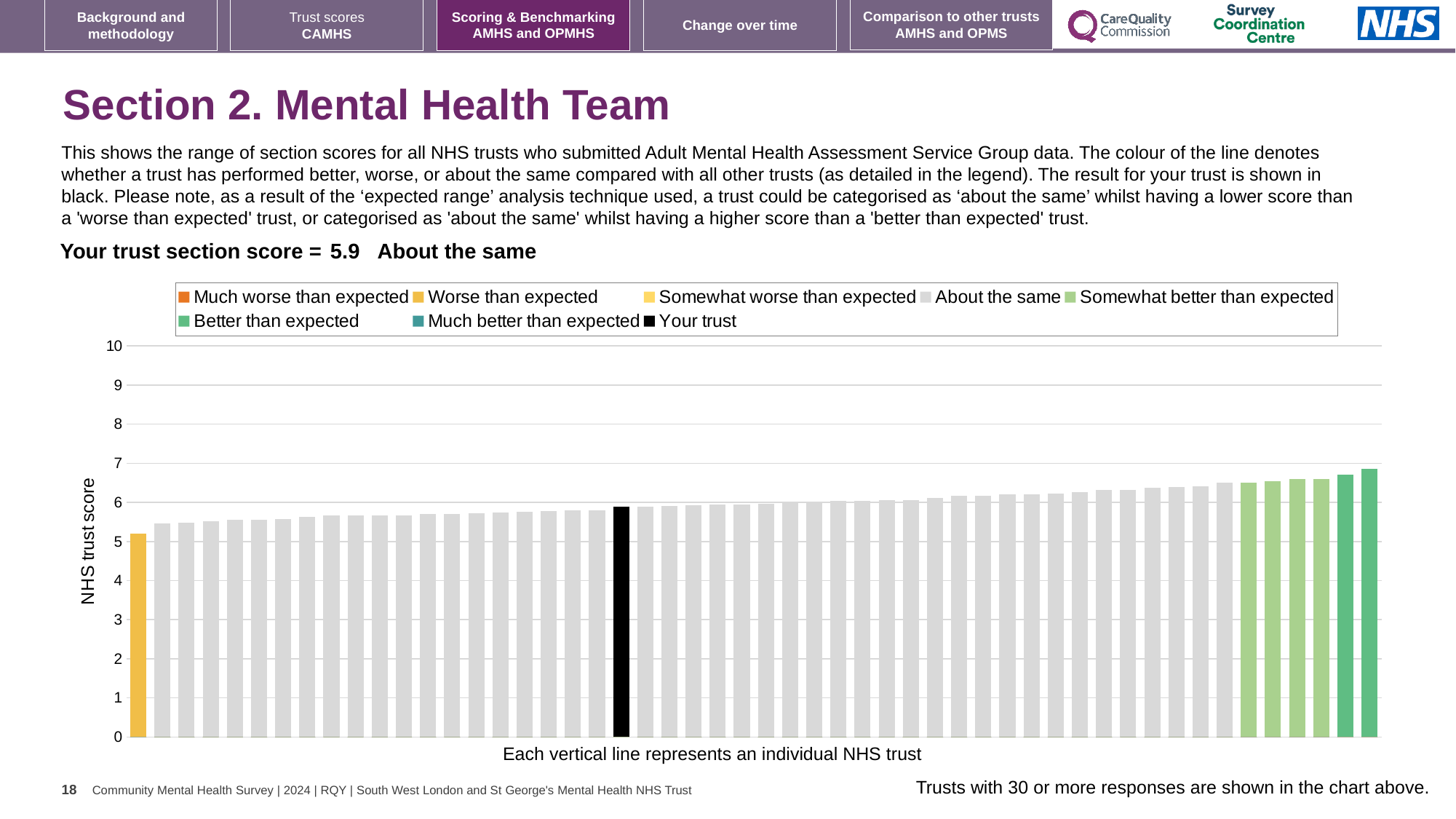
Is the value of the rightmost bar greater or less than 6? greater What kind of chart is shown on the slide? bar chart Is the value of the black 'Your trust' bar greater or less than 5? greater Do the bar values rise or fall from left to right across the chart? rise Which category is your trust placed in for this section? About the same Is the value of the leftmost bar greater or less than 6? less Which legend category does the shortest bar belong to? Worse than expected Which is higher, the black 'Your trust' bar or the leftmost bar? the black 'Your trust' bar What is the label on the vertical axis of the chart? NHS trust score What is the section score for your trust shown on the slide? 5.9 How many entries does the chart legend list? 8 Which legend category does the tallest bar belong to? Better than expected